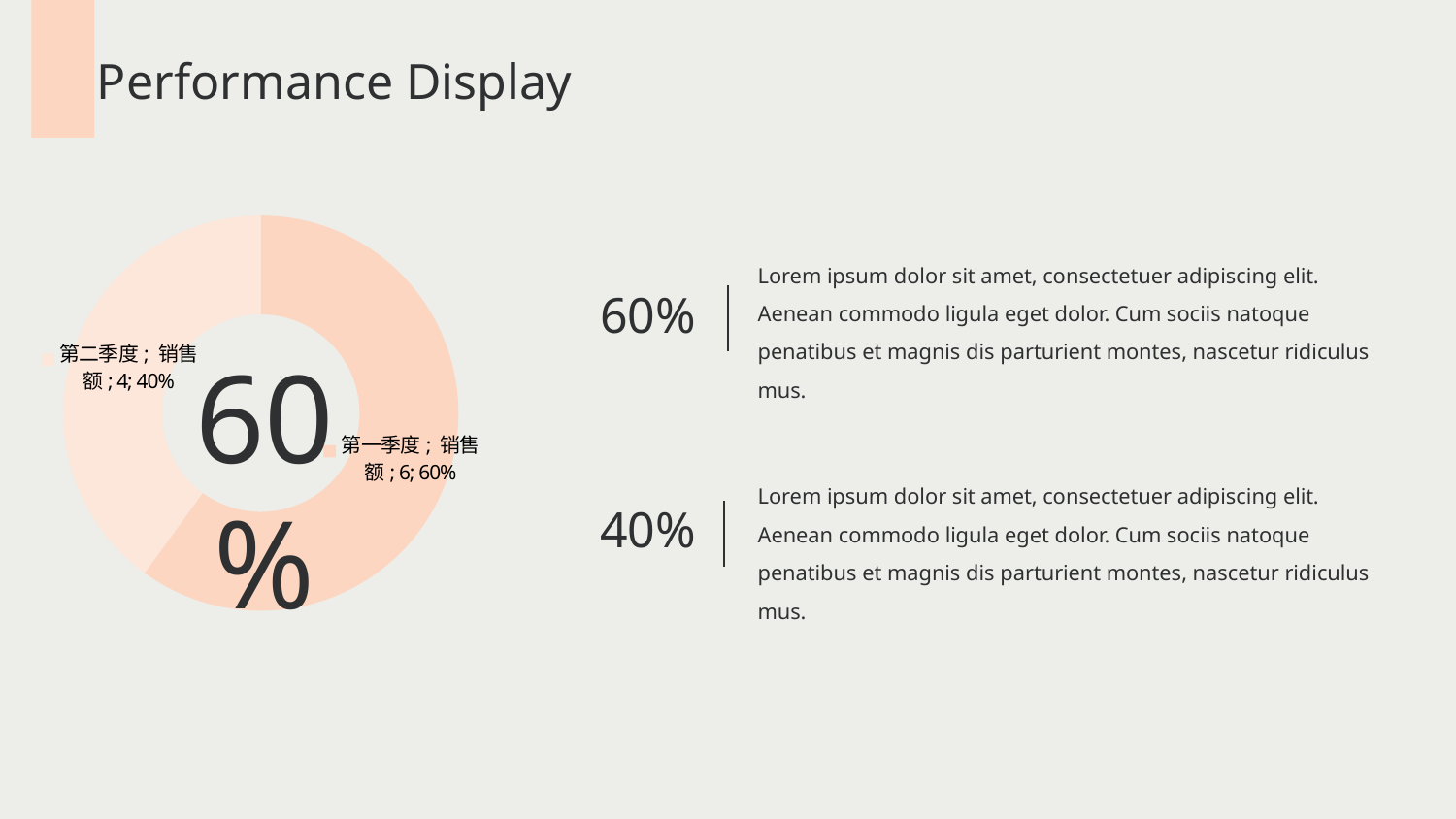
What share of the doughnut chart does 第一季度 represent? 60% Which is larger, the 销售额 for 第一季度 or for 第二季度? 第一季度 What is the difference between the 销售额 values of 第一季度 and 第二季度? 2 What kind of chart is shown on the slide? Doughnut chart What is the 销售额 value for 第二季度 in the doughnut chart? 4 What large percentage is printed in the centre of the doughnut chart? 60% What share of the doughnut chart does 第二季度 represent? 40% Which quarter has the largest slice in the doughnut chart? 第一季度 What is the total of the 销售额 values shown in the doughnut chart? 10 Which quarter has the smallest slice in the doughnut chart? 第二季度 How many slices does the doughnut chart have? 2 What is the 销售额 value for 第一季度 in the doughnut chart? 6